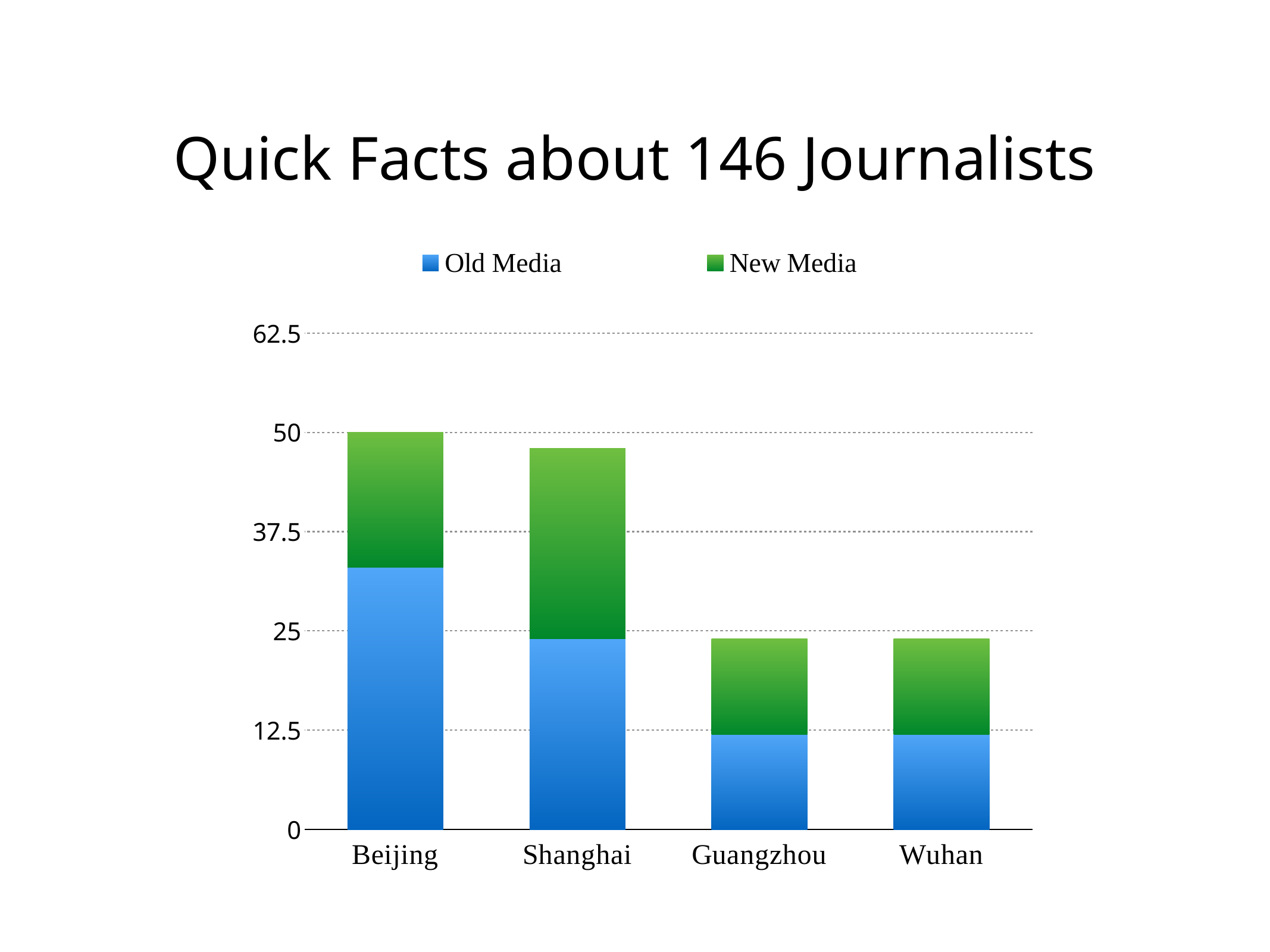
Which city has the larger Old Media value, Beijing or Shanghai? Beijing How many series does the chart's legend list? 2 What is the total height of the Beijing bar? 50 Is the total for Shanghai greater or less than 37.5? greater What are the two series named in the chart's legend? Old Media and New Media How many cities are shown on the x axis of the chart? 4 Is the Old Media value for Beijing greater or less than 25? greater What colour represents Old Media in the chart? Blue Which city has the tallest stacked bar in the chart? Beijing What kind of chart is shown on the slide? Stacked bar chart Is the New Media value for Shanghai greater or less than 12.5? greater